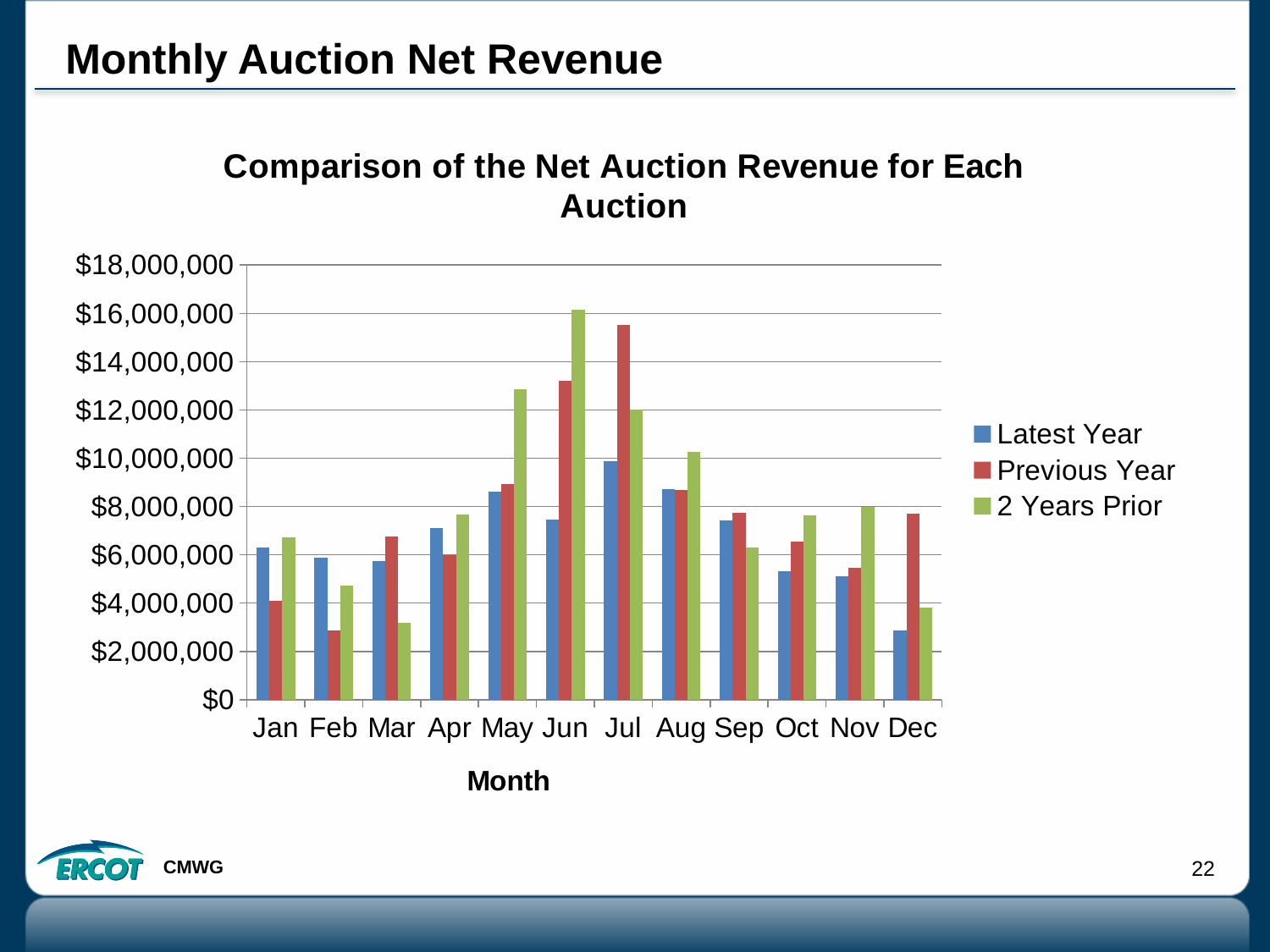
How many series does the legend list? 3 In Jul, which is larger: the Previous Year value or the 2 Years Prior value? Previous Year What is the label on the x axis of the chart? Month In Jun, which is larger: the Previous Year value or the 2 Years Prior value? 2 Years Prior What kind of chart is shown on the slide? Bar chart Is the Latest Year value for Dec greater or less than $4,000,000? less Is the Previous Year value for Jul greater or less than $14,000,000? greater In which month is the Latest Year value highest? Jul In which month is the 2 Years Prior value highest? Jun In which month is the Latest Year value lowest? Dec How many months are shown on the x axis? 12 In which month is the Previous Year value lowest? Feb